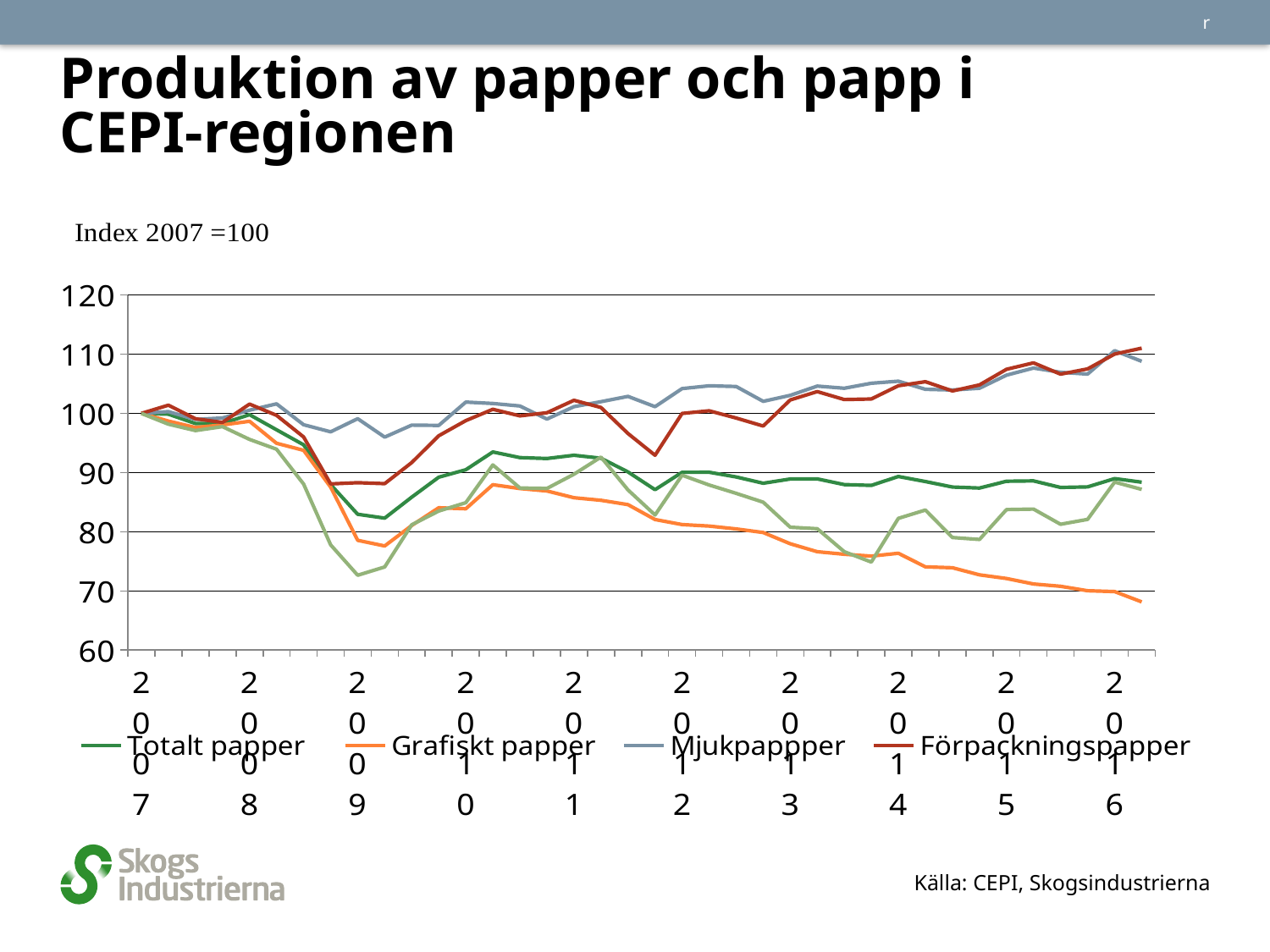
Is the value for Grafiskt papper in 2009 greater or less than 80? less Is the value for Grafiskt papper at the end of 2016 greater or less than 70? less Does the Grafiskt papper line rise or fall from 2007 to 2016? fall Does the Förpackningspapper line rise or fall from 2009 to 2016? rise Is the value for Mjukpappper at the end of 2016 greater or less than 100? greater Which series has the lowest value at the end of the chart (2016)? Grafiskt papper What kind of chart is shown on the slide? line chart At the end of 2016, which is higher: Totalt papper or Grafiskt papper? Totalt papper What base year and value does the index use, according to the slide? Index 2007 =100 What is the title of the chart on the slide? Produktion av papper och papp i CEPI-regionen How many series does the legend list? 4